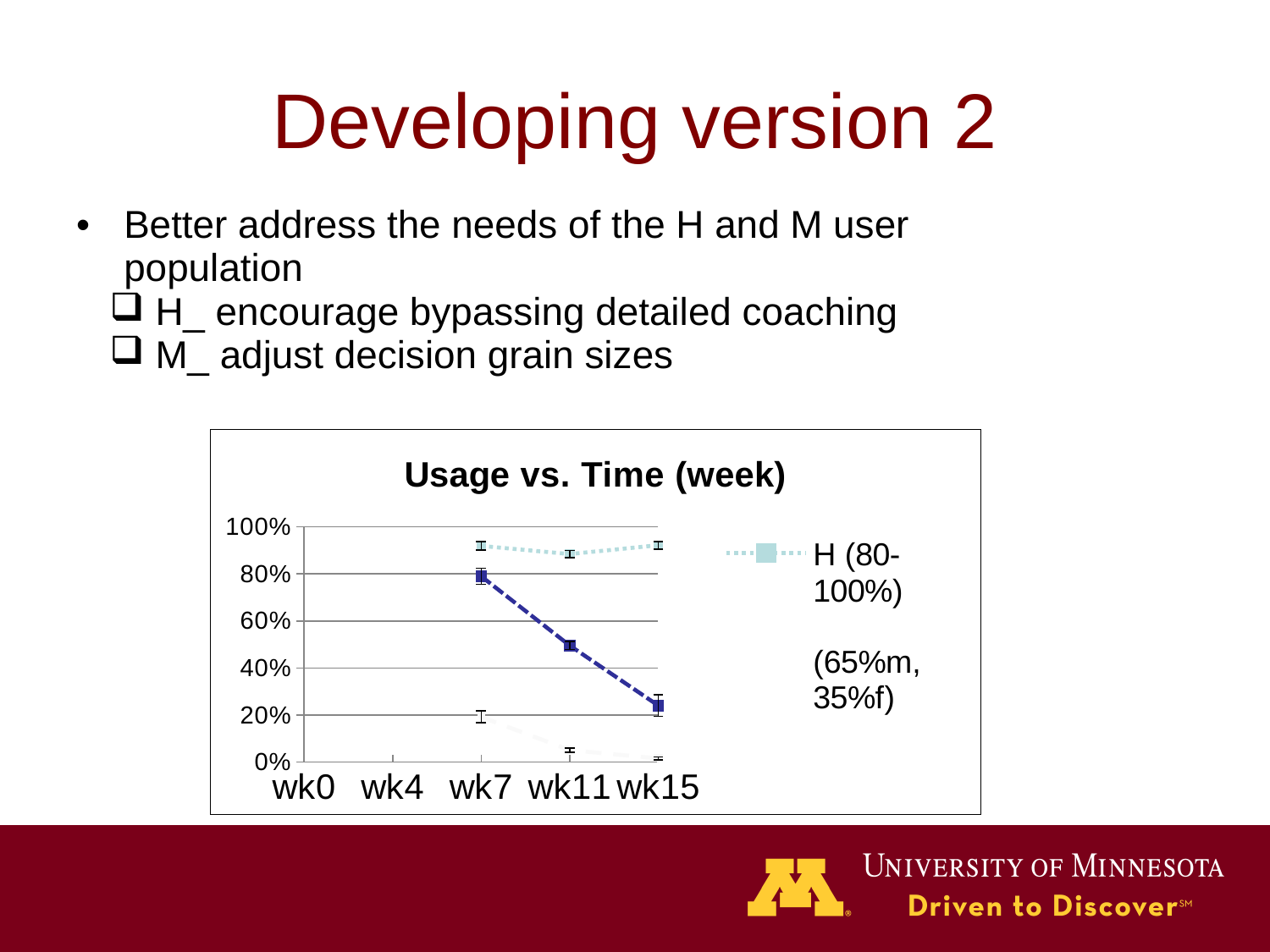
Is the value of the dark blue dashed series at wk15 greater or less than 40%? less Is the value of the H (80-100%) series at wk7 greater or less than 80%? greater Is the value of the dark blue dashed series at wk11 greater or less than 80%? less Does the dark blue dashed series rise or fall from wk7 to wk15? fall How many week labels are shown on the x axis of the chart? 5 At wk11, which is higher: the H (80-100%) series or the dark blue dashed series? H (80-100%) At wk15, which is higher: the H (80-100%) series or the dark blue dashed series? H (80-100%) Which series name is readable in the chart's legend? H (80-100%) What is the title of the chart? Usage vs. Time (week) What kind of chart is shown on the slide? line chart